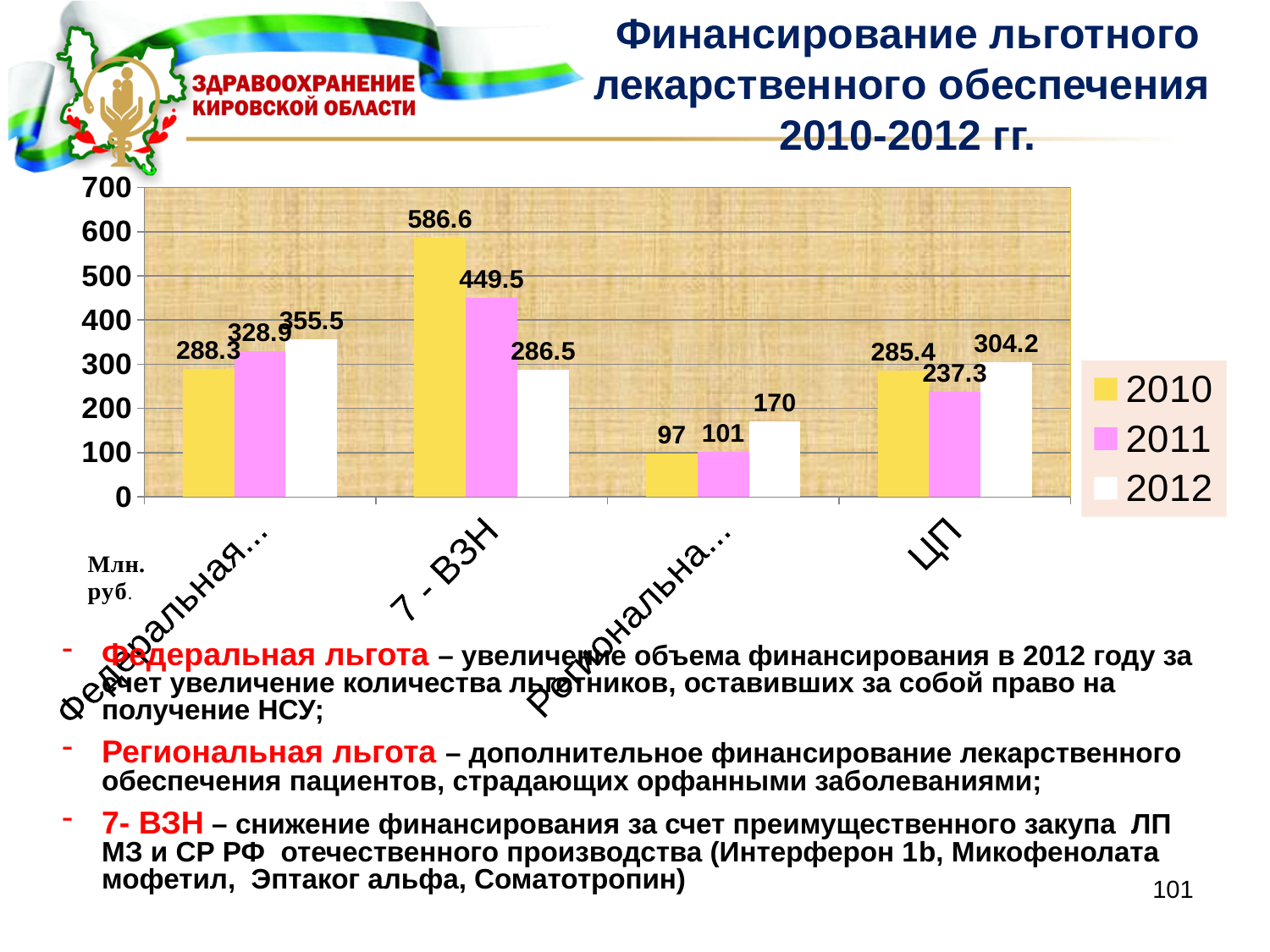
Which category has the highest 2010 value? 7 - ВЗН What is the 2012 value for the Региональна... category? 170 Do the values for 7 - ВЗН rise or fall from 2010 to 2012? fall How many series does the legend list? 3 How many categories are shown on the x axis? 4 What is the value for ЦП in 2011? 237.3 What type of chart is shown on the slide? bar chart Which is larger for ЦП: the 2010 value or the 2012 value? 2012 What is the value for 7 - ВЗН in 2010? 586.6 Which series is shown in yellow in the legend? 2010 Which category has the lowest 2011 value? Региональна... What is the difference between the 2010 and 2012 values for 7 - ВЗН? 300.1